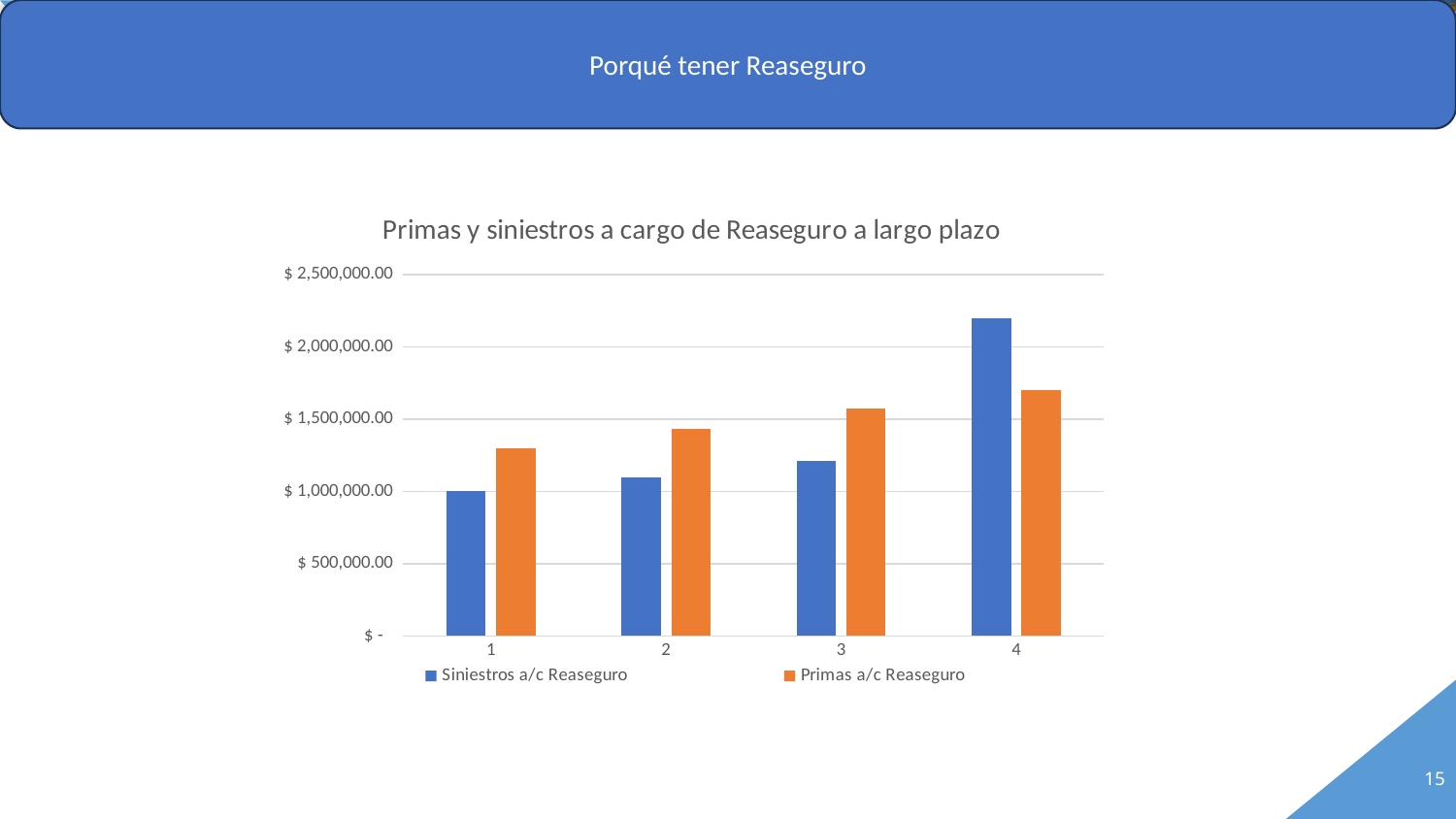
Do the values for Primas a/c Reaseguro rise or fall from category 1 to category 4? rise In category 1, which is larger: Siniestros a/c Reaseguro or Primas a/c Reaseguro? Primas a/c Reaseguro How many categories are shown on the x axis? 4 Which series is shown in orange? Primas a/c Reaseguro How many series does the legend list? 2 For which category is Siniestros a/c Reaseguro highest? 4 What kind of chart is shown on the slide? Bar chart For which category is Primas a/c Reaseguro lowest? 1 What is the title of the chart? Primas y siniestros a cargo de Reaseguro a largo plazo Is the value for Primas a/c Reaseguro in category 2 greater or less than $ 1,500,000.00? less Is the value for Siniestros a/c Reaseguro in category 4 greater or less than $ 2,000,000.00? greater In category 4, which is larger: Siniestros a/c Reaseguro or Primas a/c Reaseguro? Siniestros a/c Reaseguro